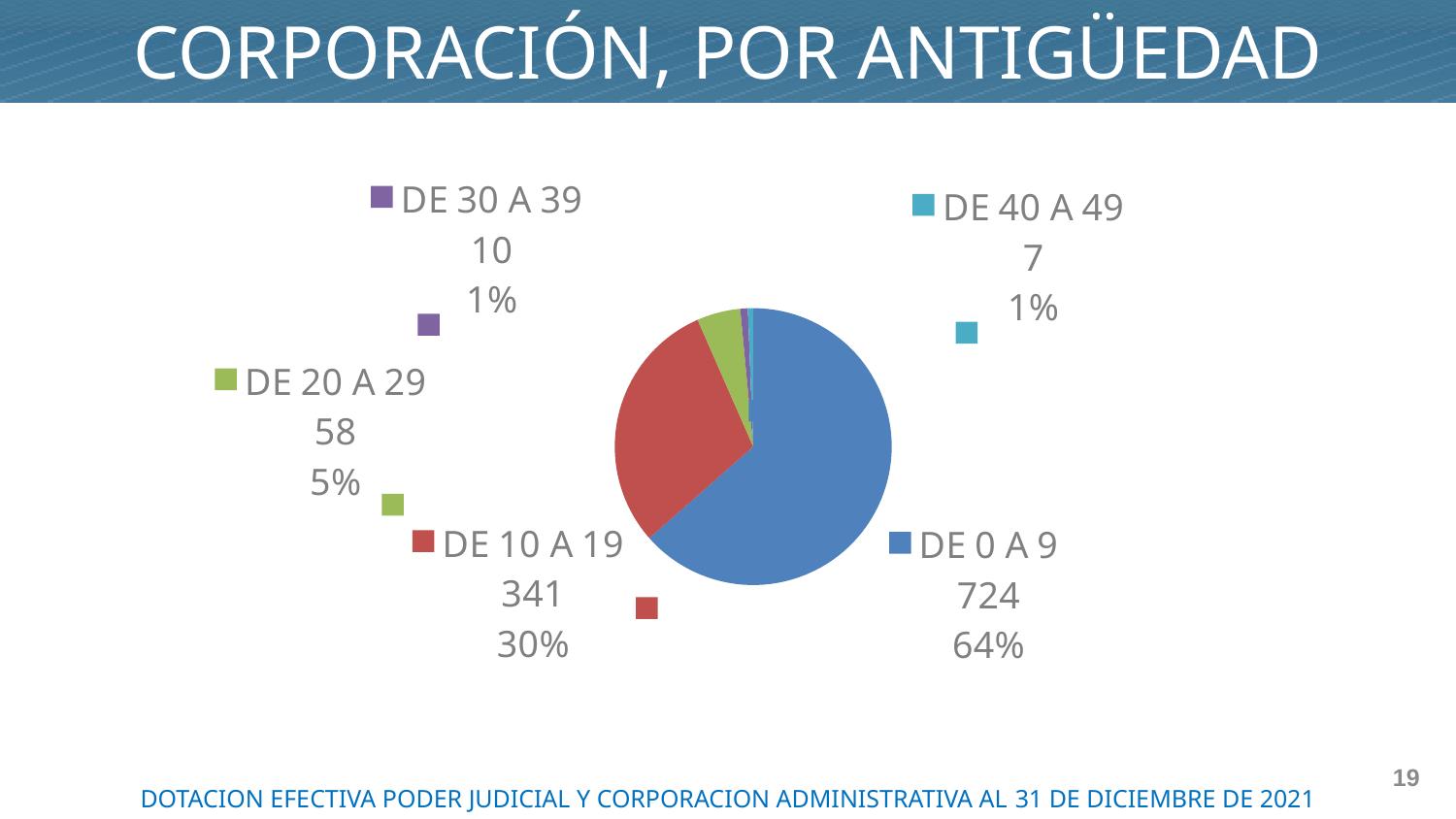
Which category has the largest slice? DE 0 A 9 What share of the pie does DE 10 A 19 represent? 30% How many categories are shown in the chart? 5 What is the difference between the values for DE 0 A 9 and DE 10 A 19? 383 What share of the pie does DE 0 A 9 represent? 64% What is the value for DE 10 A 19? 341 What is the value for DE 40 A 49? 7 Which category has the smallest slice? DE 40 A 49 What is the value for DE 20 A 29? 58 Which is larger, DE 20 A 29 or DE 30 A 39? DE 20 A 29 What kind of chart is shown on the slide? Pie chart What is the value for DE 0 A 9? 724